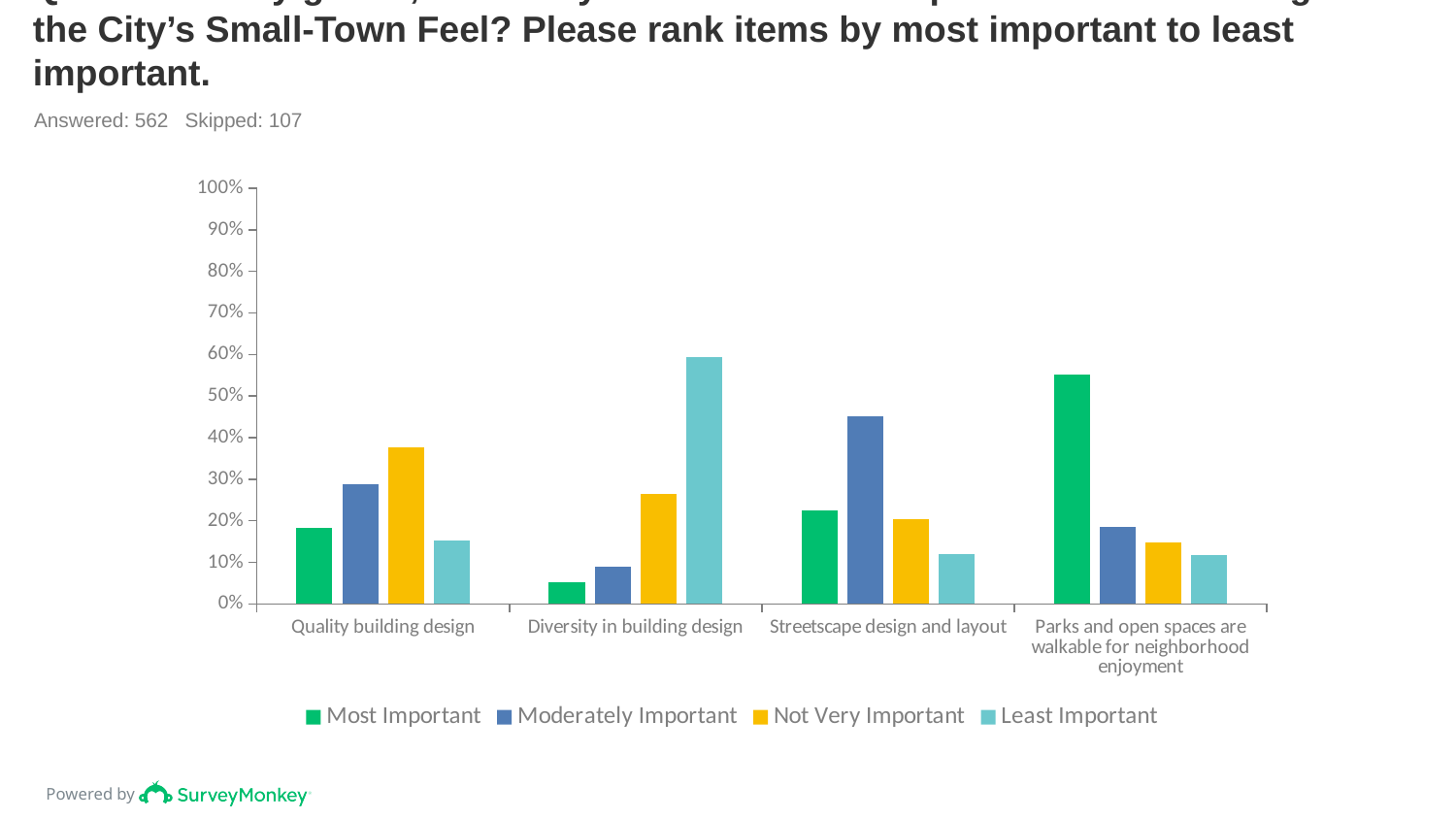
Which series has the tallest bar for Diversity in building design? Least Important Is the Most Important value for Quality building design greater or less than 10%? greater What kind of chart is shown on the slide? bar chart Which category has the lowest Most Important bar? Diversity in building design What colour represents the Most Important series in the legend? green Is the Least Important value for Diversity in building design greater or less than 50%? greater How many respondents answered this question according to the slide? 562 Which category has the highest Most Important bar? Parks and open spaces are walkable for neighborhood enjoyment How many series does the legend list? 4 How many categories are shown on the x axis? 4 Is the Moderately Important value for Streetscape design and layout greater or less than 40%? greater For Quality building design, which is larger: Not Very Important or Moderately Important? Not Very Important